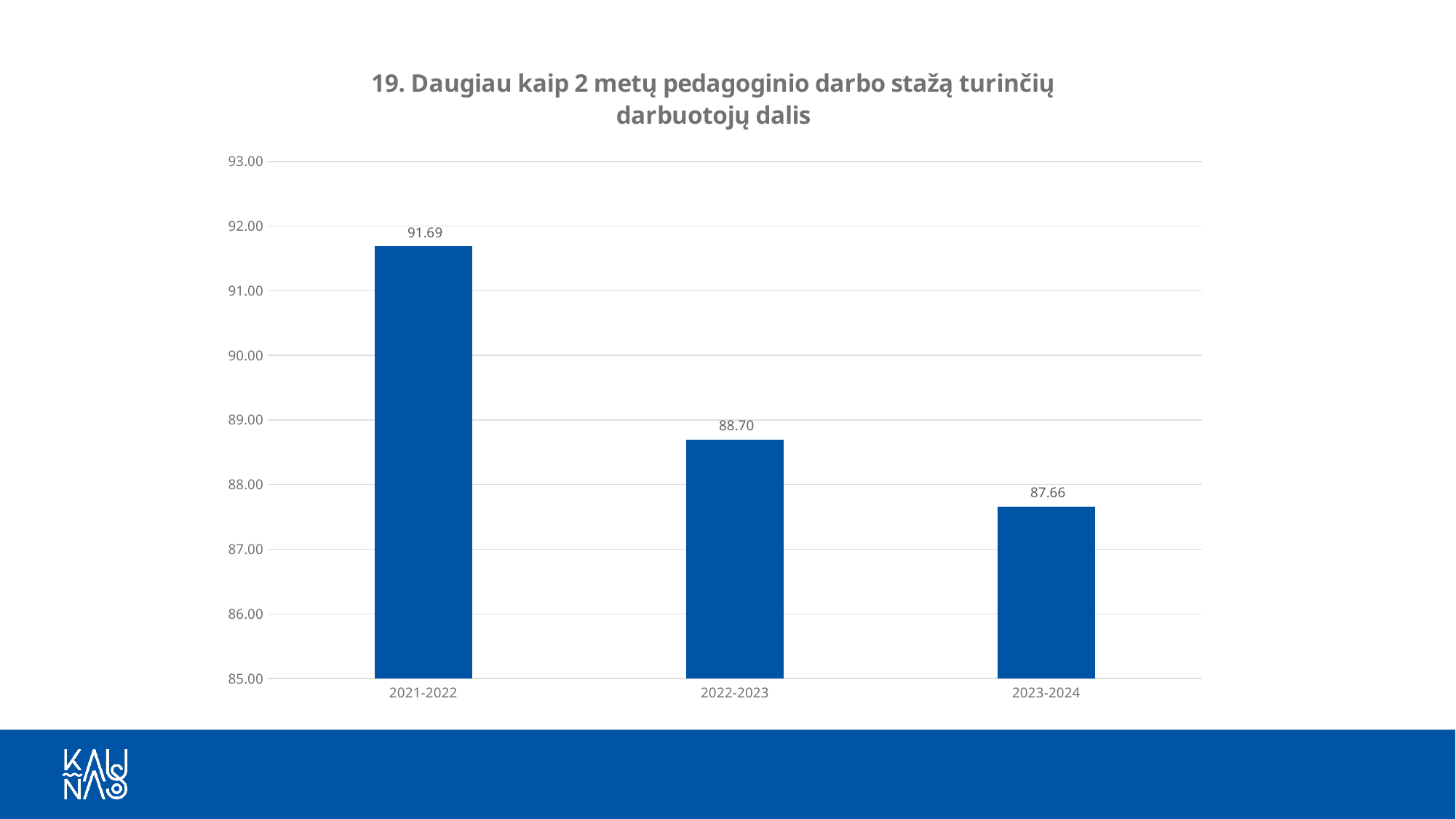
What kind of chart is shown on the slide? bar chart What is the value for 2021-2022? 91.69 What is the difference between the values for 2021-2022 and 2023-2024? 4.03 What is the difference between the values for 2022-2023 and 2023-2024? 1.04 What is the value for 2023-2024? 87.66 How many periods are shown on the x axis? 3 Which period has the lowest value? 2023-2024 What is the value for 2022-2023? 88.70 Which period has the highest value? 2021-2022 Do the values rise or fall from 2021-2022 to 2023-2024? fall Is the value for 2021-2022 greater or less than 91.00? greater Which is larger, the value for 2022-2023 or the value for 2023-2024? 2022-2023